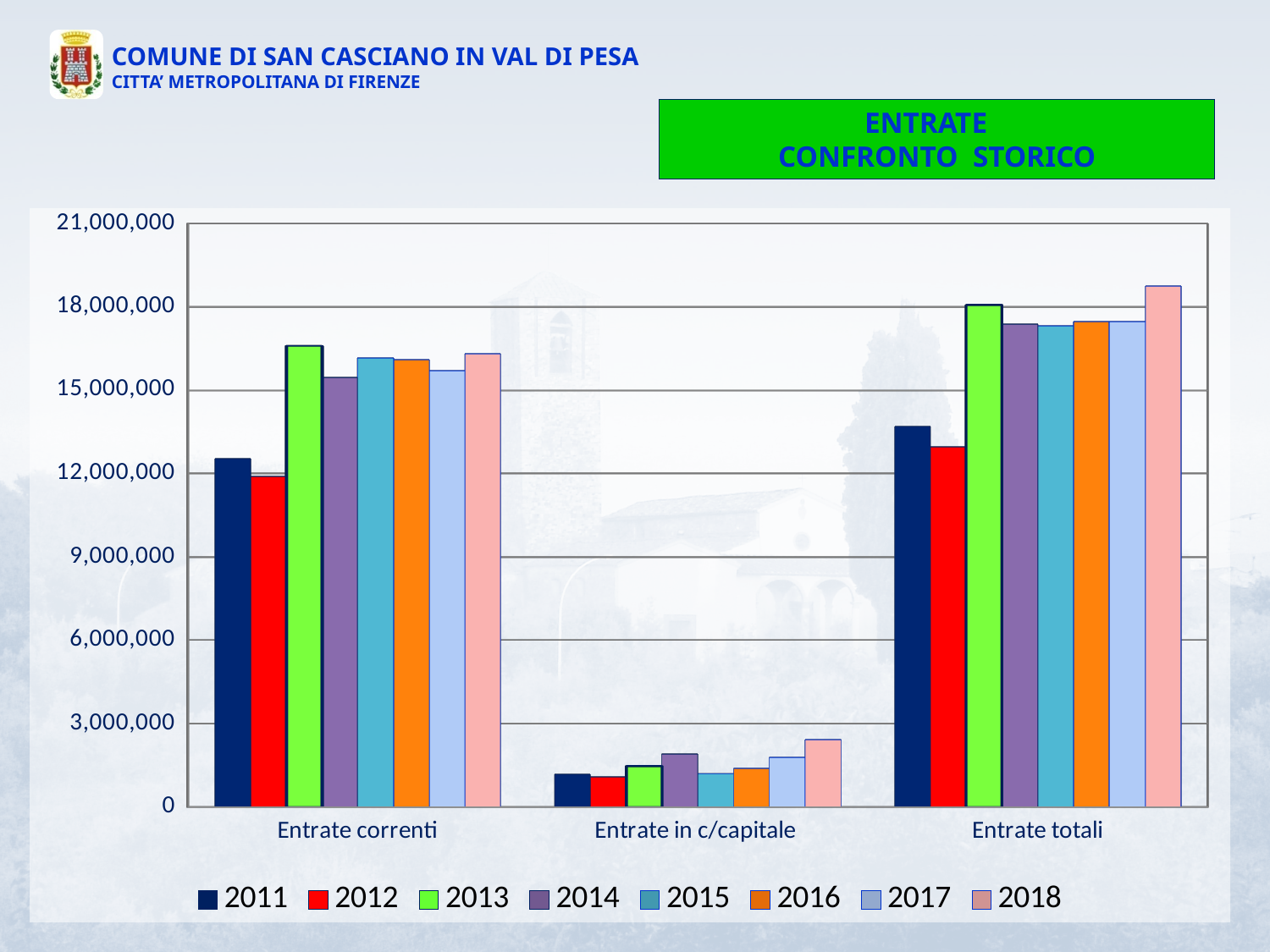
Is the value for 2012 in Entrate totali greater or less than 15,000,000? less How many series (years) does the legend list? 8 What is the title shown in the green box above the chart? ENTRATE CONFRONTO STORICO Which year has the highest value for Entrate totali? 2018 For Entrate correnti, which is larger: the value for 2011 or the value for 2012? 2011 How many categories are shown on the x axis? 3 Which year has the highest value for Entrate in c/capitale? 2018 Is the value for 2018 in Entrate totali greater or less than 18,000,000? greater Which year has the lowest value for Entrate correnti? 2012 What kind of chart is shown on the slide? Bar chart Is the value for 2013 in Entrate correnti greater or less than 15,000,000? greater